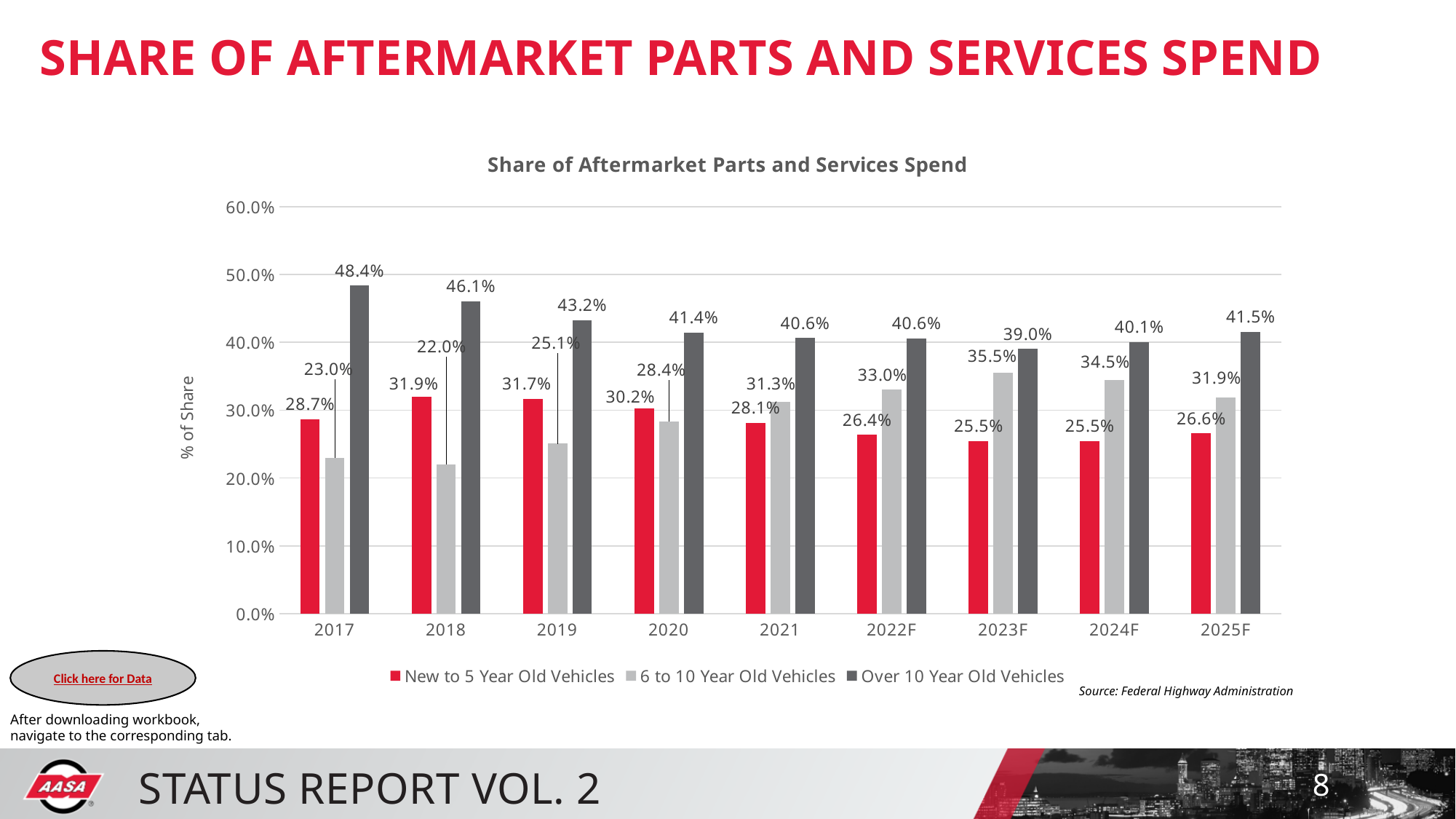
In which year is the share for 6 to 10 Year Old Vehicles lowest? 2018 In 2021, which is larger: the share for New to 5 Year Old Vehicles or for 6 to 10 Year Old Vehicles? 6 to 10 Year Old Vehicles What is the share for Over 10 Year Old Vehicles in 2017? 48.4% What kind of chart is shown on the slide? Bar chart What is the share for New to 5 Year Old Vehicles in 2025F? 26.6% How many years are shown on the x axis? 9 In which year is the share for Over 10 Year Old Vehicles highest? 2017 Is the share for Over 10 Year Old Vehicles in 2023F greater or less than 40.0%? less Does the share for New to 5 Year Old Vehicles rise or fall from 2018 to 2024F? Fall How many series does the legend list? 3 What is the difference between the Over 10 Year Old Vehicles share and the New to 5 Year Old Vehicles share in 2017? 19.7 percentage points What is the share for 6 to 10 Year Old Vehicles in 2023F? 35.5%